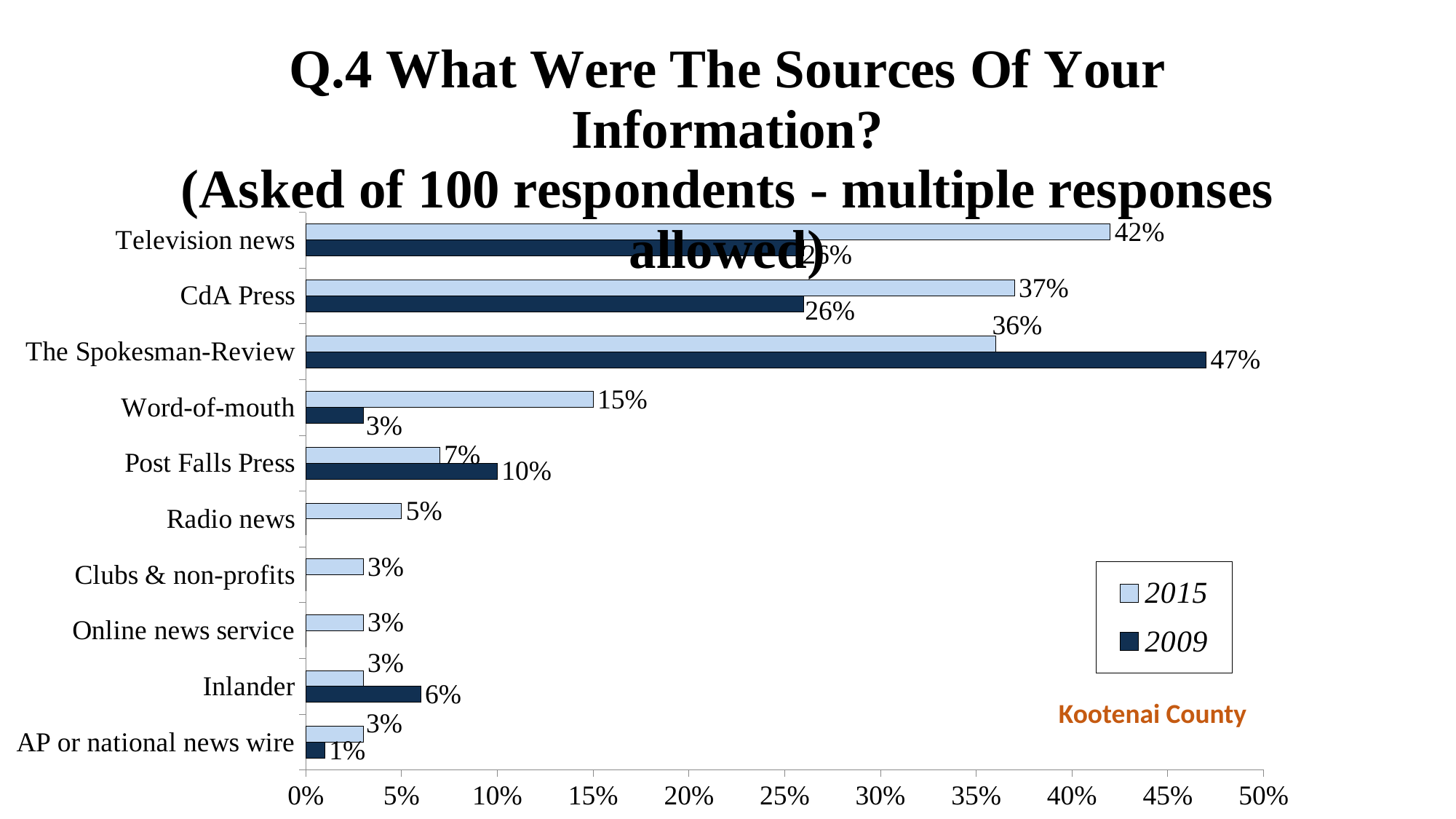
Which source had the highest value in 2015? Television news What percentage of respondents cited Television news as a source in 2015? 42% What is the difference between the 2015 and 2009 values for Word-of-mouth? 12 percentage points How many series does the legend list? 2 What was the 2009 value for Post Falls Press? 10% What was the 2015 value for CdA Press? 37% How many sources (categories) are listed on the chart? 10 What type of chart is shown on the slide? Bar chart Which source had the lowest value in 2009 among those with a 2009 bar? AP or national news wire Which source had the highest value in 2009? The Spokesman-Review What was the 2009 value for The Spokesman-Review? 47% Which is larger for The Spokesman-Review, the 2015 value or the 2009 value? 2009